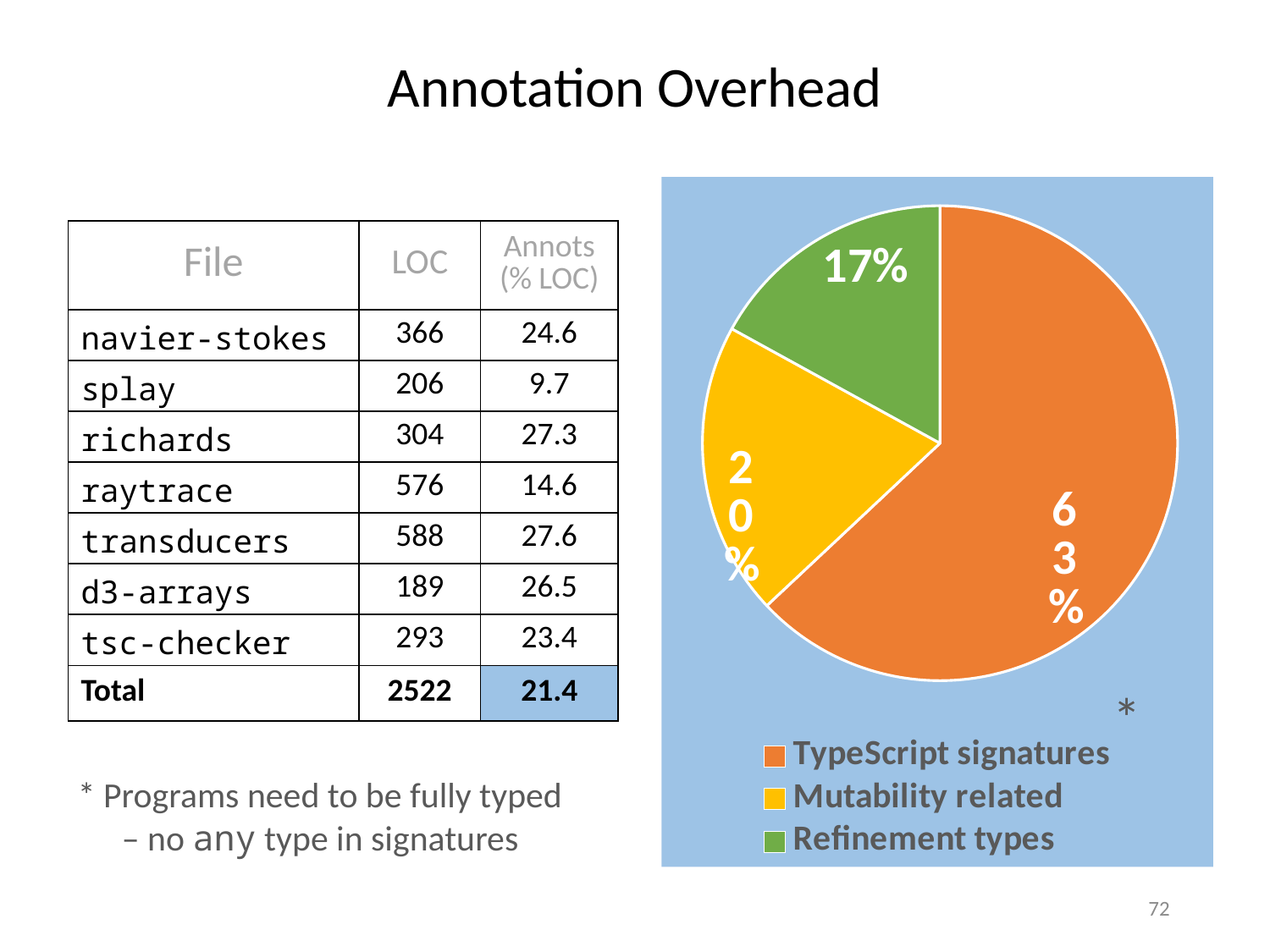
In the pie chart, what share is labelled for TypeScript signatures? 63% In the pie chart, what share is labelled for Mutability related? 20% Which slice of the pie chart is the largest? TypeScript signatures Which slice of the pie chart is the smallest? Refinement types How many slices does the pie chart have? 3 In the pie chart, which is larger: Mutability related or Refinement types? Mutability related What kind of chart is shown on the right side of the slide? pie chart In the pie chart, what share is labelled for Refinement types? 17% What colour is the Refinement types slice in the pie chart? green In the pie chart, what is the difference in percentage points between TypeScript signatures and Mutability related? 43 How many entries does the pie chart's legend list? 3 In the pie chart, what is the difference in percentage points between Mutability related and Refinement types? 3